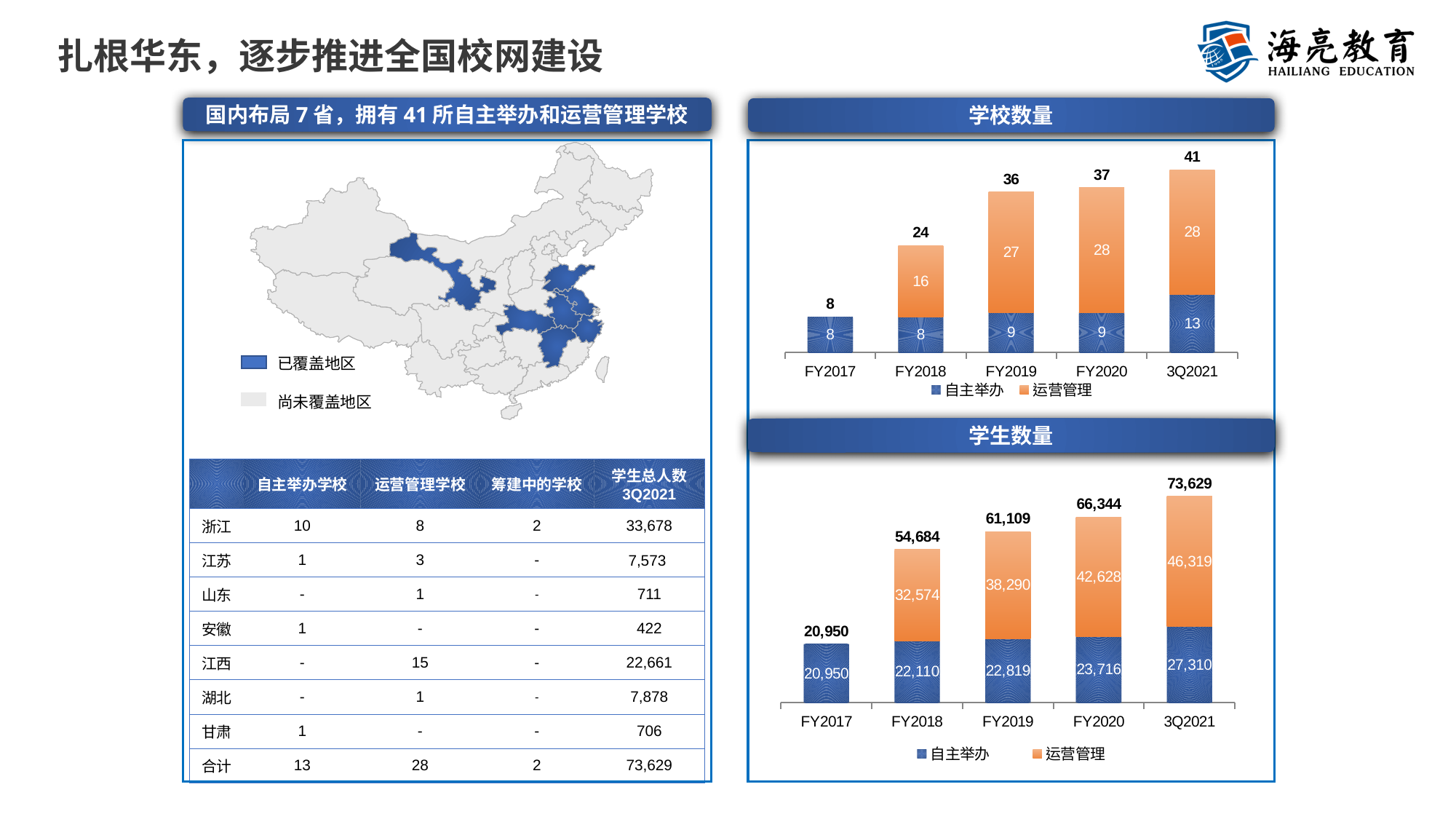
In the 学校数量 chart, what is the difference between the 运营管理 values for 3Q2021 and FY2018? 12 In the 学校数量 chart, how many series does the legend list? 2 In the 学校数量 chart, what is the 运营管理 value for FY2019? 27 In the 学生数量 chart, do the total values rise or fall from FY2017 to 3Q2021? rise What kind of chart is the 学生数量 chart? stacked bar chart In the 学校数量 chart, what is the total number of schools in 3Q2021? 41 In the 学生数量 chart, what is the total number of students in FY2019? 61,109 In the 学生数量 chart, what is the 运营管理 value for FY2020? 42,628 In the 学生数量 chart, what is the 自主举办 value for 3Q2021? 27,310 In the 学生数量 chart, which period has the highest total number of students? 3Q2021 In the 学校数量 chart, what is the 自主举办 value for FY2017? 8 In the 学校数量 chart, which period has the lowest total number of schools? FY2017